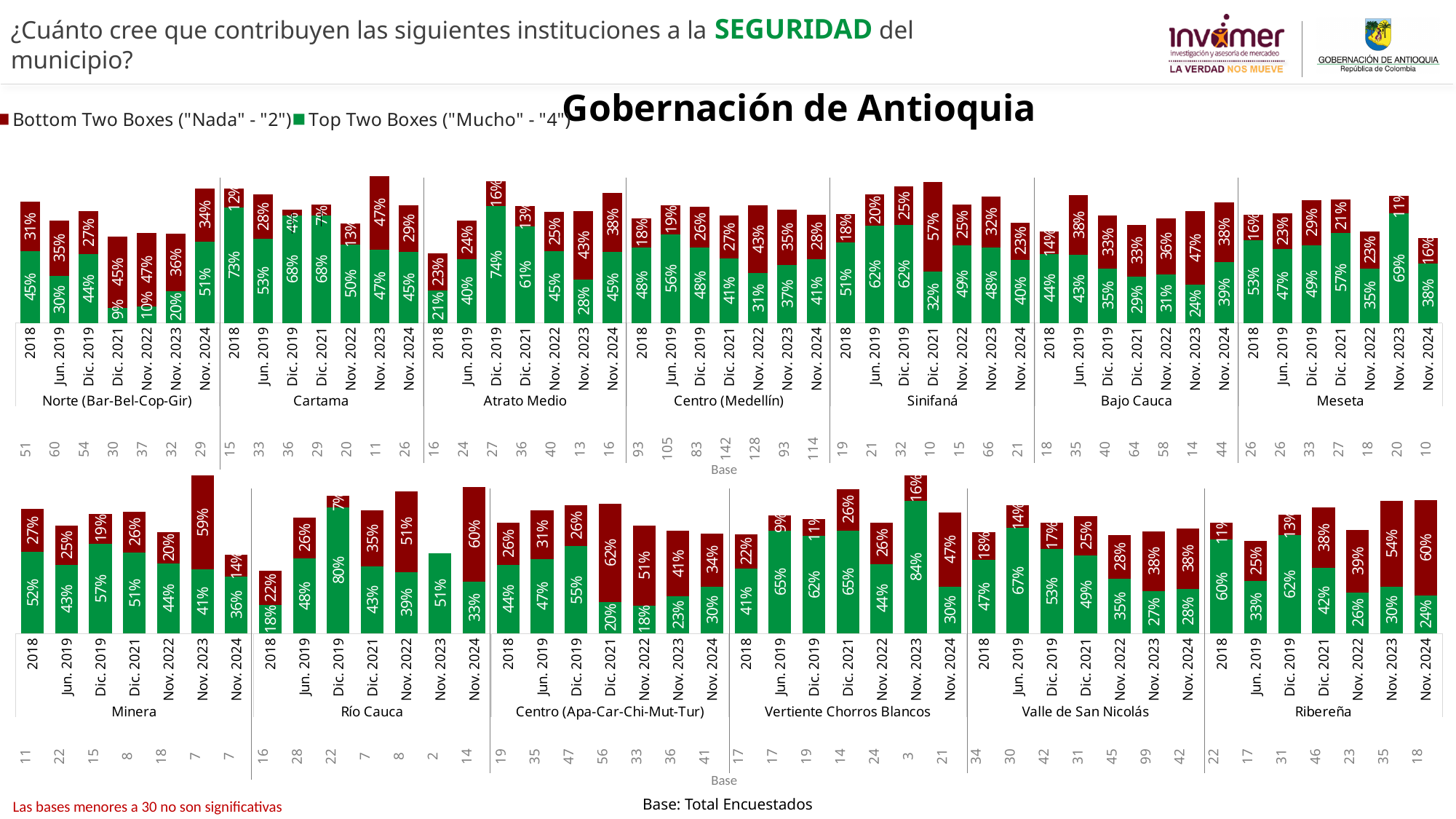
In the top chart, what is the Bottom Two Boxes value for Sinifaná in Dic. 2021? 57% In the bottom chart, what is the difference between the Top Two Boxes values for Río Cauca in Dic. 2019 and Nov. 2024? 47% What kind of chart is shown on the slide? Stacked bar chart In the top chart, which period has the lowest Top Two Boxes value for Norte (Bar-Bel-Cop-Gir)? Dic. 2021 In the top chart, which period has the highest Top Two Boxes value for Atrato Medio? Dic. 2019 In the top chart, what is the Top Two Boxes value for Cartama in 2018? 73% In the bottom chart, what is the Bottom Two Boxes value for Ribereña in Nov. 2024? 60% In the bottom chart, which is larger for Minera in Nov. 2023: the Top Two Boxes value or the Bottom Two Boxes value? Bottom Two Boxes In the top chart, what is the total of the stacked bar for Meseta in Nov. 2023? 80% How many series does the legend list? 2 In the bottom chart, what is the Top Two Boxes value for Vertiente Chorros Blancos in Nov. 2023? 84% In the bottom chart, how many periods are shown for Valle de San Nicolás? 7